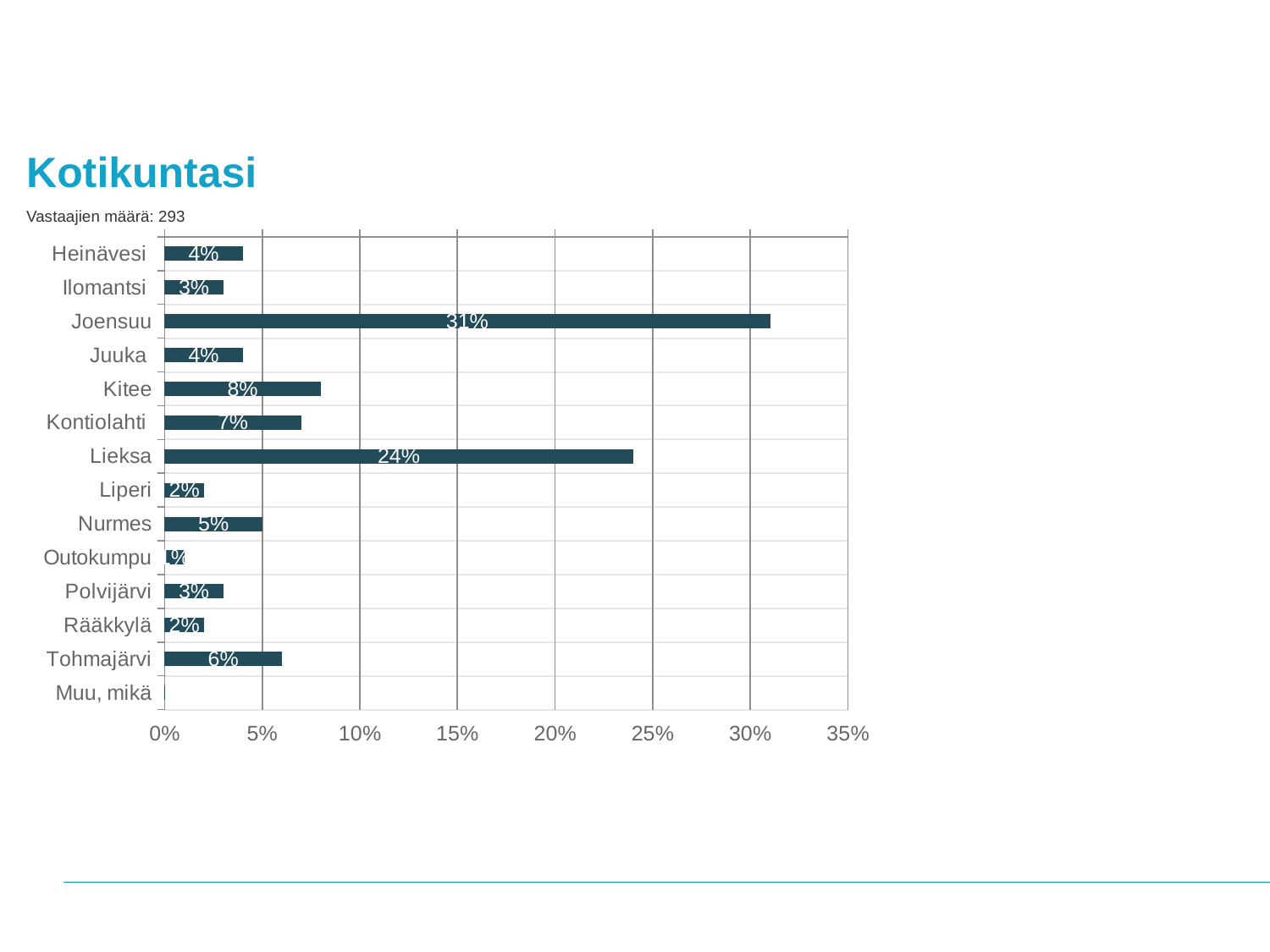
What is the difference between the values for Kitee and Kontiolahti? 1% What is the difference between the values for Joensuu and Lieksa? 7% Which municipality has the highest share of respondents? Joensuu How many categories are listed on the vertical axis of the chart? 14 What percentage is shown for Kitee? 8% What is the value shown for Lieksa? 24% What is the value for Tohmajärvi? 6% Is the value for Joensuu greater or less than 30%? greater What percentage of respondents are from Joensuu? 31% What is the title of the chart? Kotikuntasi What type of chart is shown on the slide? Bar chart Which has a larger value, Nurmes or Tohmajärvi? Tohmajärvi